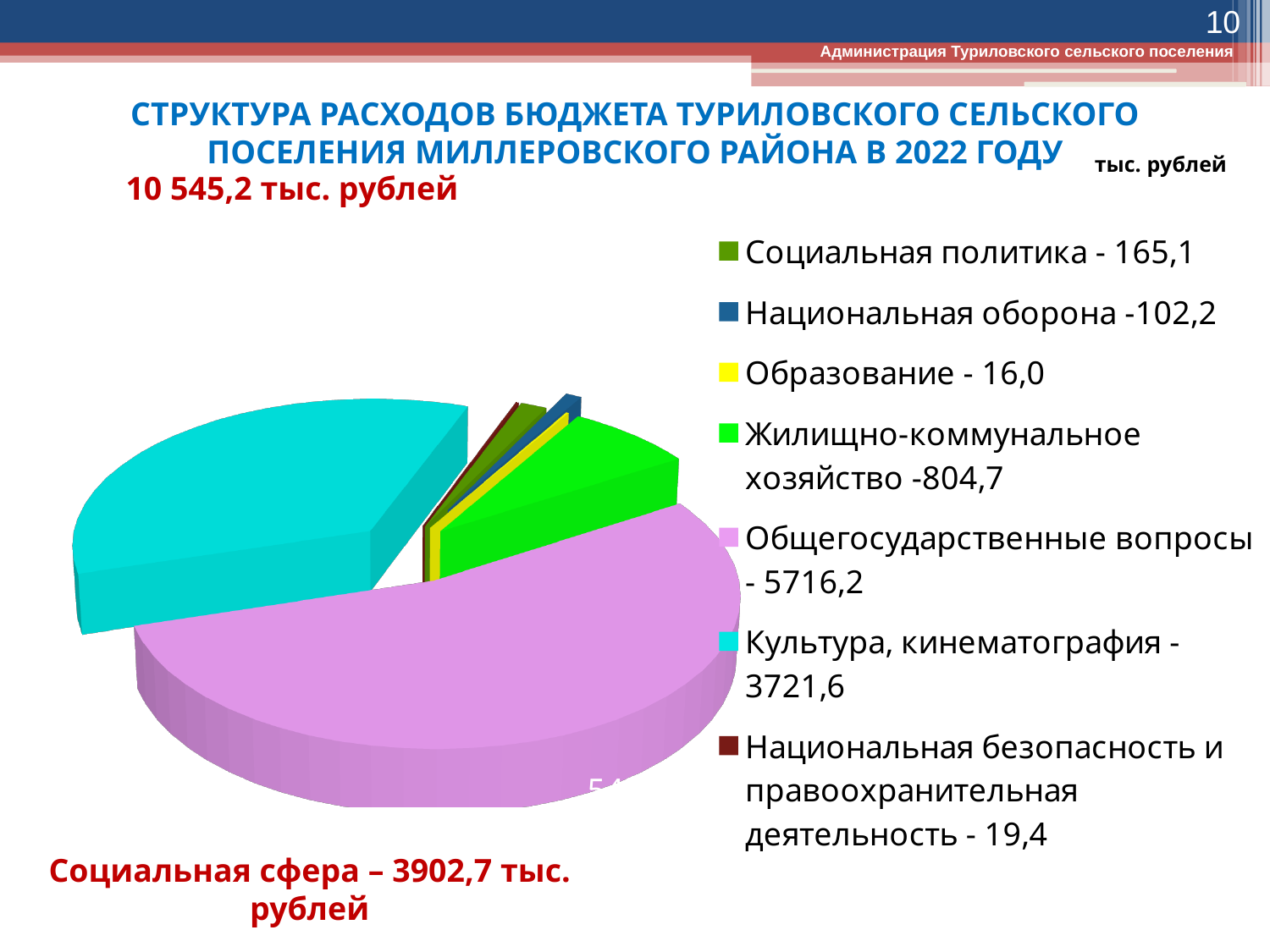
What is the value for Жилищно-коммунальное хозяйство? 804,7 What is the total of all expenditures shown on the slide, in thousand rubles? 10 545,2 тыс. рублей How many categories does the pie chart's legend list? 7 What colour is the slice for Культура, кинематография? Cyan (turquoise) What type of chart is shown on the slide? Pie chart Which is larger: Социальная политика or Национальная оборона? Социальная политика Which category has the largest value? Общегосударственные вопросы Which category has the smallest value? Образование What is the value for Общегосударственные вопросы? 5716,2 What is the value for Культура, кинематография? 3721,6 What is the value for Национальная оборона? 102,2 What is the difference between Общегосударственные вопросы and Культура, кинематография? 1994,6